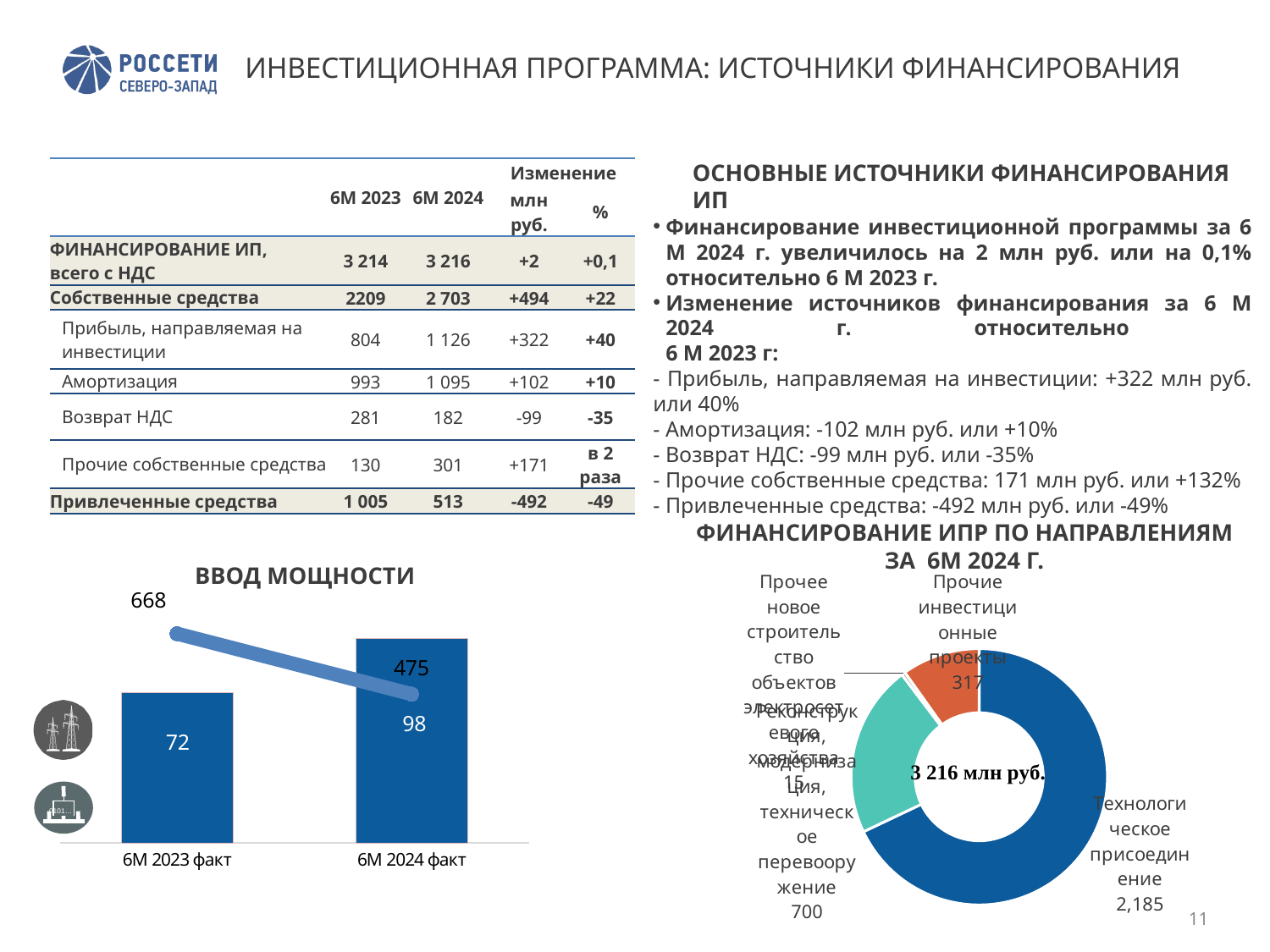
In the "ВВОД МОЩНОСТИ" chart, what value is printed inside the bar for 6М 2024 факт? 98 In the "ВВОД МОЩНОСТИ" chart, what value is printed inside the bar for 6М 2023 факт? 72 What kind of chart is "ФИНАНСИРОВАНИЕ ИПР ПО НАПРАВЛЕНИЯМ ЗА 6М 2024 Г."? doughnut chart In the "ФИНАНСИРОВАНИЕ ИПР ПО НАПРАВЛЕНИЯМ ЗА 6М 2024 Г." chart, what total is printed in the centre of the doughnut? 3 216 млн руб. What kind of chart is the "ВВОД МОЩНОСТИ" chart? combination bar and line chart In the "ФИНАНСИРОВАНИЕ ИПР ПО НАПРАВЛЕНИЯМ ЗА 6М 2024 Г." chart, which segment is the largest? Технологическое присоединение In the "ФИНАНСИРОВАНИЕ ИПР ПО НАПРАВЛЕНИЯМ ЗА 6М 2024 Г." chart, what is the value for Технологическое присоединение? 2,185 In the "ФИНАНСИРОВАНИЕ ИПР ПО НАПРАВЛЕНИЯМ ЗА 6М 2024 Г." chart, what is the value for Реконструкция, модернизация, техническое перевооружение? 700 In the "ВВОД МОЩНОСТИ" chart, which category has the taller bar, 6М 2023 факт or 6М 2024 факт? 6М 2024 факт In the "ВВОД МОЩНОСТИ" chart, does the line series rise or fall from 6М 2023 факт to 6М 2024 факт? fall In the "ВВОД МОЩНОСТИ" chart, what is the difference between the bar values for 6М 2024 факт and 6М 2023 факт? 26 In the "ВВОД МОЩНОСТИ" chart, what value is labelled at the start of the line for 6М 2023 факт? 668